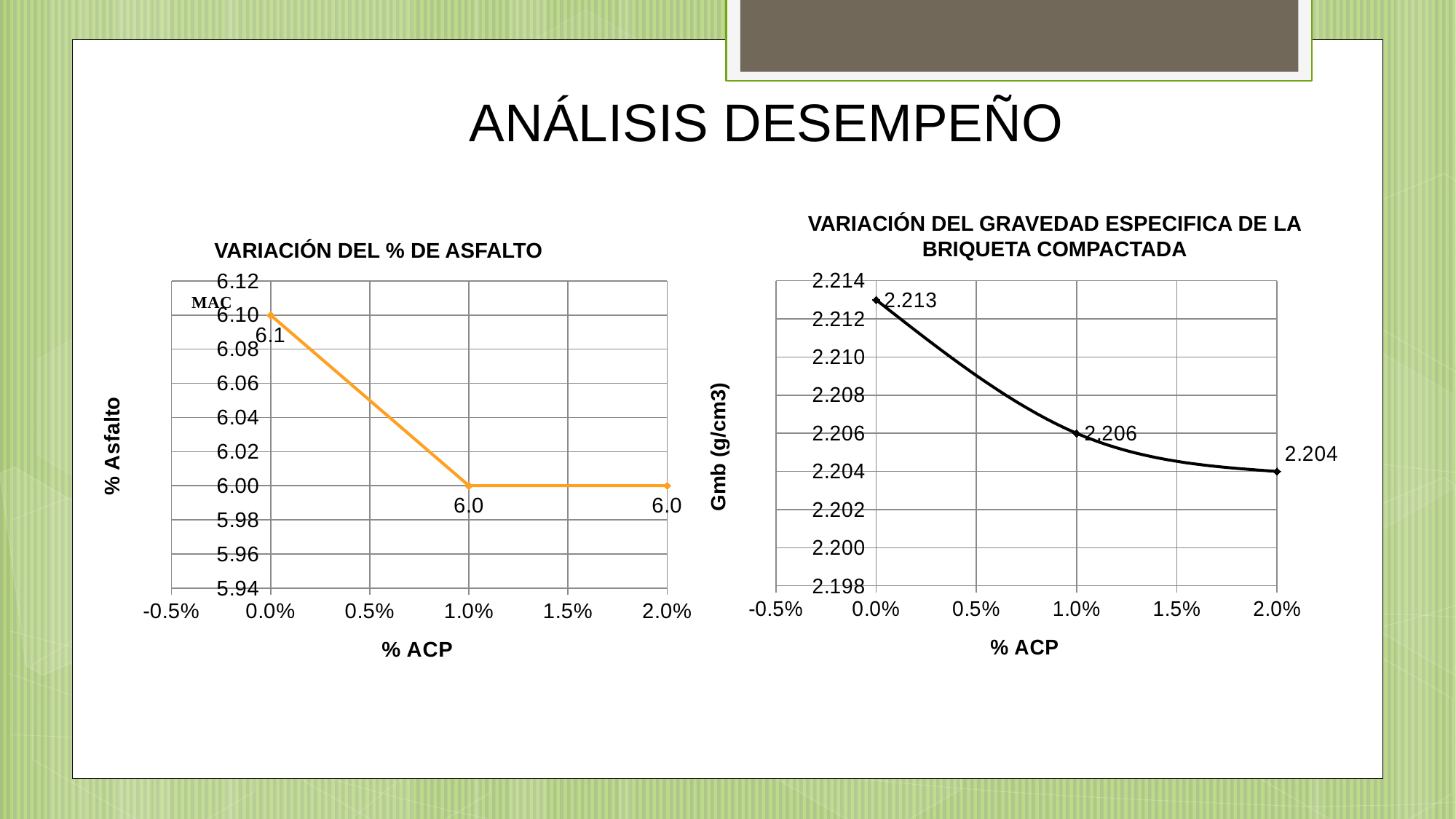
In the chart titled 'VARIACIÓN DEL GRAVEDAD ESPECIFICA DE LA BRIQUETA COMPACTADA', what is the label of the y axis? Gmb (g/cm3) In the chart titled 'VARIACIÓN DEL GRAVEDAD ESPECIFICA DE LA BRIQUETA COMPACTADA', what is the Gmb value at 0.0% ACP? 2.213 In the chart titled 'VARIACIÓN DEL GRAVEDAD ESPECIFICA DE LA BRIQUETA COMPACTADA', do the Gmb values rise or fall as % ACP increases? Fall In the chart titled 'VARIACIÓN DEL GRAVEDAD ESPECIFICA DE LA BRIQUETA COMPACTADA', what is the Gmb value at 2.0% ACP? 2.204 In the chart titled 'VARIACIÓN DEL % DE ASFALTO', what kind of chart is shown? Line chart In the chart titled 'VARIACIÓN DEL GRAVEDAD ESPECIFICA DE LA BRIQUETA COMPACTADA', at which % ACP is the Gmb value lowest? 2.0% In the chart titled 'VARIACIÓN DEL % DE ASFALTO', how many data points are plotted? 3 In the chart titled 'VARIACIÓN DEL % DE ASFALTO', what is the % Asfalto value at 1.0% ACP? 6.0 In the chart titled 'VARIACIÓN DEL % DE ASFALTO', what is the % Asfalto value at 0.0% ACP? 6.1 In the chart titled 'VARIACIÓN DEL % DE ASFALTO', what is the label of the y axis? % Asfalto In the chart titled 'VARIACIÓN DEL GRAVEDAD ESPECIFICA DE LA BRIQUETA COMPACTADA', what is the difference between the Gmb value at 0.0% ACP and at 1.0% ACP? 0.007 In the chart titled 'VARIACIÓN DEL % DE ASFALTO', what is the difference between the value at 0.0% ACP and the value at 2.0% ACP? 0.1